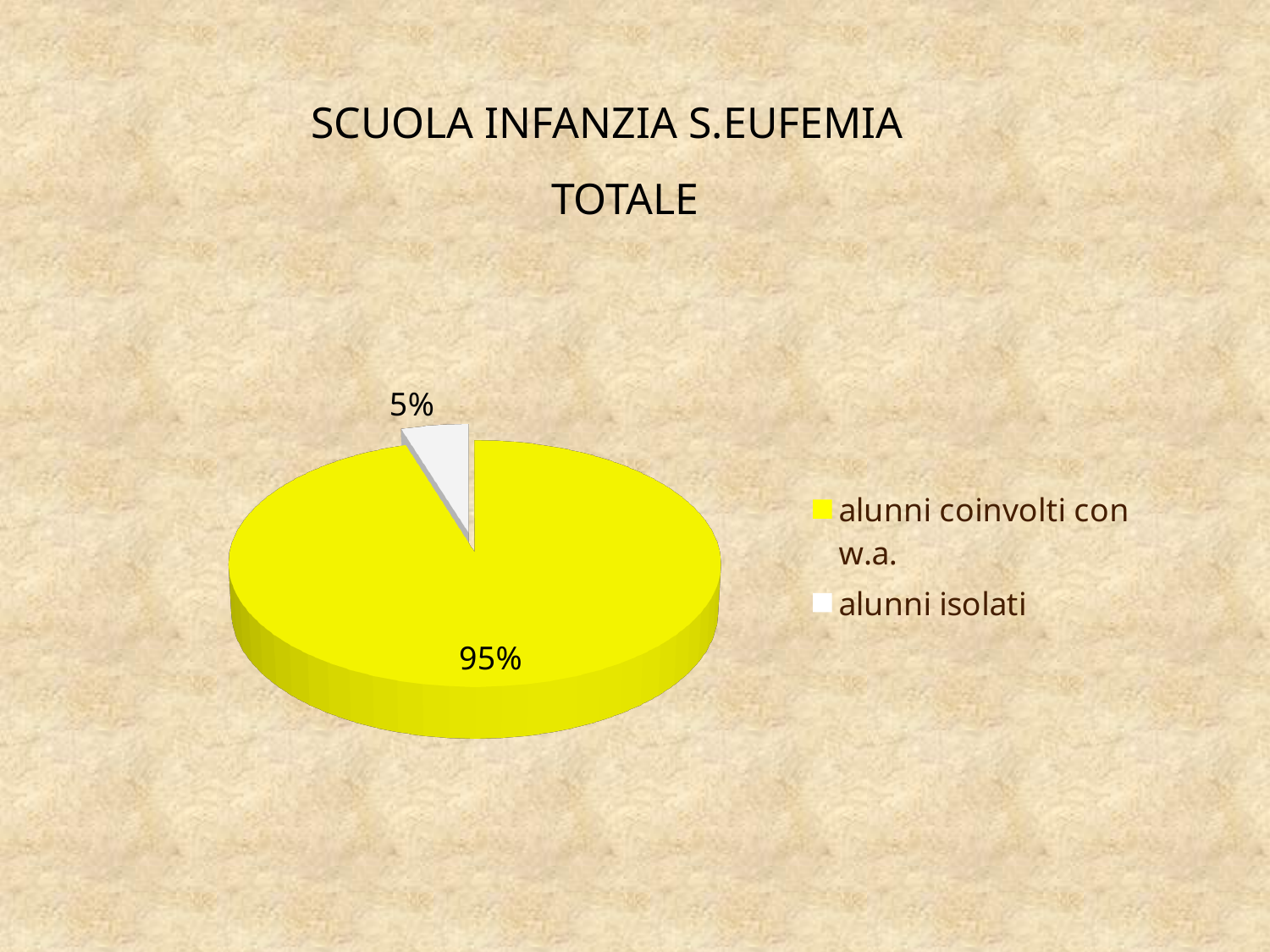
What colour is the slice for "alunni coinvolti con w.a."? yellow What share of the pie is labelled "alunni coinvolti con w.a."? 95% What is the difference in percentage points between the "alunni coinvolti con w.a." slice and the "alunni isolati" slice? 90 How many entries does the legend list? 2 Which category has the smallest slice of the pie? alunni isolati What share of the pie is labelled "alunni isolati"? 5% What is the title shown above the chart? SCUOLA INFANZIA S.EUFEMIA TOTALE What kind of chart is shown on the slide? pie chart How many slices does the pie chart have? 2 Which category has the largest slice of the pie? alunni coinvolti con w.a. Which slice is larger, "alunni coinvolti con w.a." or "alunni isolati"? alunni coinvolti con w.a.